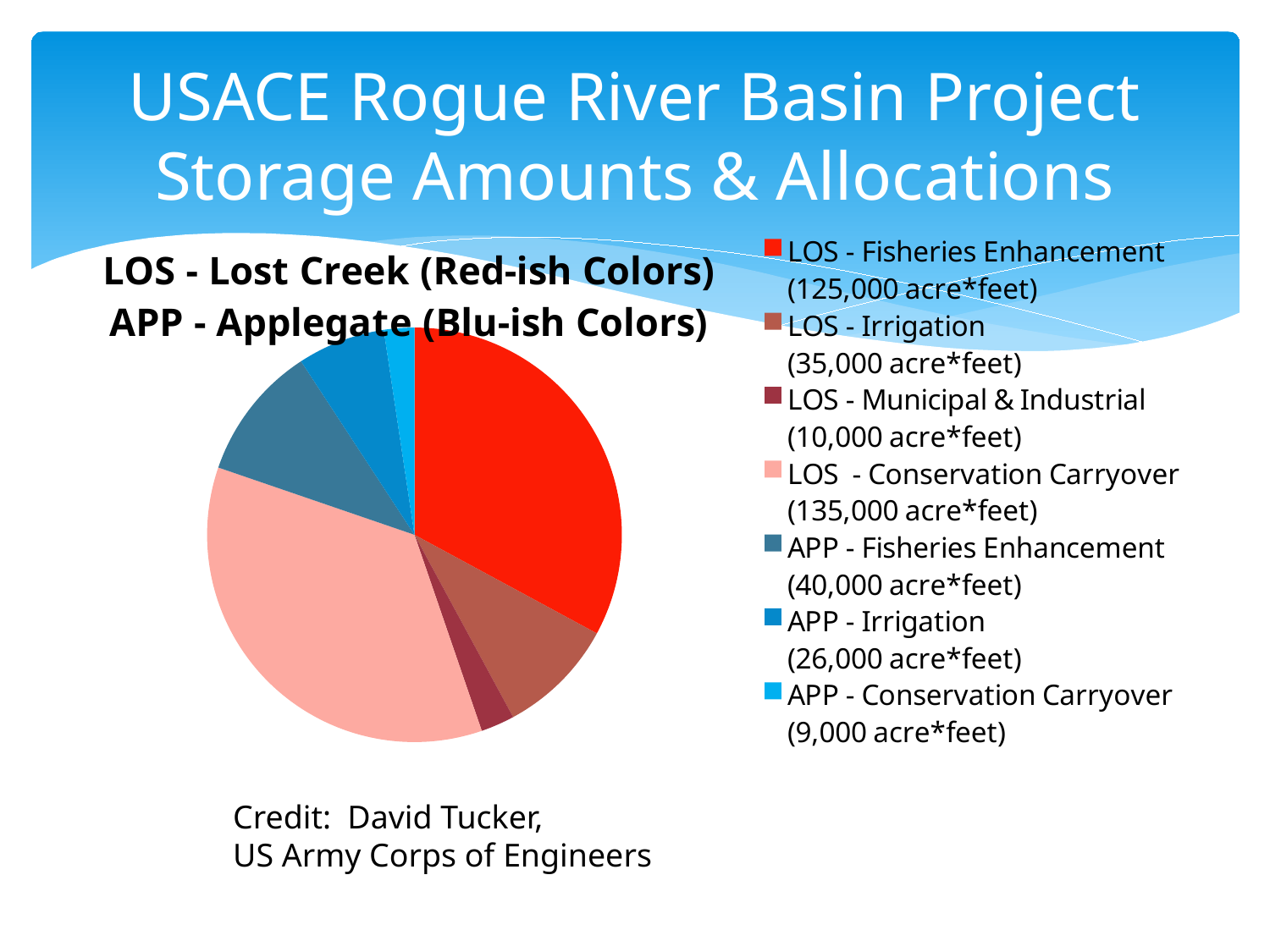
According to the slide, which colours represent the Applegate (APP) categories? Blu-ish colors Which category has the largest storage amount? LOS - Conservation Carryover What is the storage amount for LOS - Municipal & Industrial? 10,000 acre*feet Which is larger, LOS - Irrigation or APP - Fisheries Enhancement? APP - Fisheries Enhancement What is the total storage amount across all seven categories in the pie chart? 380,000 acre*feet What kind of chart is shown on the slide? Pie chart Which category has the smallest storage amount? APP - Conservation Carryover What is the storage amount for LOS - Fisheries Enhancement? 125,000 acre*feet What is the storage amount for APP - Irrigation? 26,000 acre*feet What is the difference between APP - Fisheries Enhancement and APP - Irrigation? 14,000 acre*feet What is the difference between LOS - Conservation Carryover and LOS - Fisheries Enhancement? 10,000 acre*feet How many categories (slices) does the pie chart have? 7